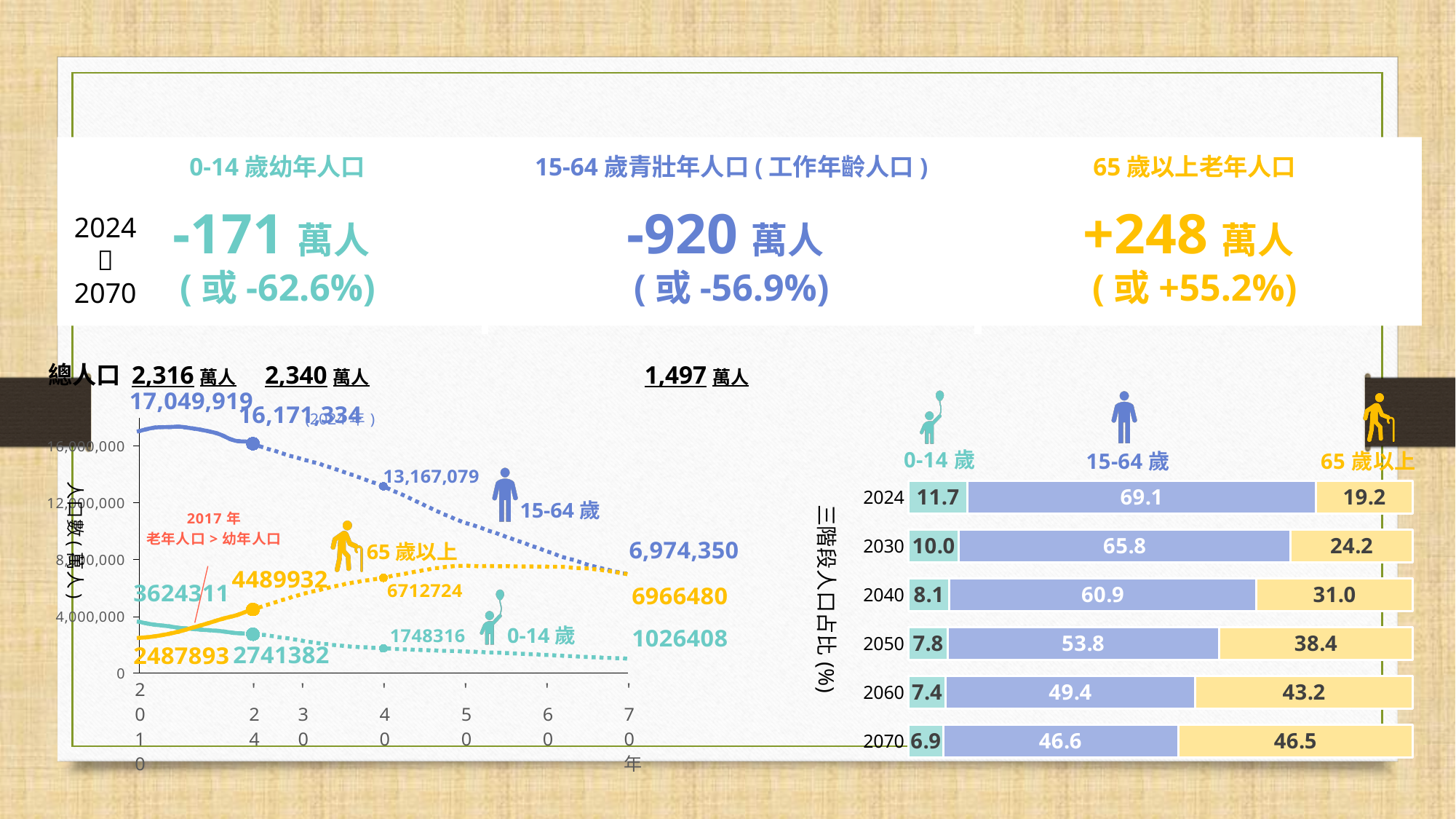
In the stacked bar chart on the right, what is the value for 0-14 歲 in 2050? 7.8 In the line chart on the left, what is the value for 15-64 歲 in 2040? 13,167,079 What kind of chart is the chart on the left? line chart In the stacked bar chart on the right, how many years are shown? 6 In the stacked bar chart on the right, what is the value for 15-64 歲 in 2024? 69.1 In the stacked bar chart on the right, does the 0-14 歲 value rise or fall from 2024 to 2070? fall In the line chart on the left, what is the value for 0-14 歲 in 2070? 1026408 In the line chart on the left, which age group has the highest value in 2010? 15-64 歲 In the stacked bar chart on the right, which year has the highest value for 65 歲以上? 2070 In the stacked bar chart on the right, what is the difference between the 15-64 歲 values for 2024 and 2070? 22.5 In the stacked bar chart on the right, what is the value for 65 歲以上 in 2070? 46.5 In the stacked bar chart on the right, which year has the lowest value for 15-64 歲? 2070